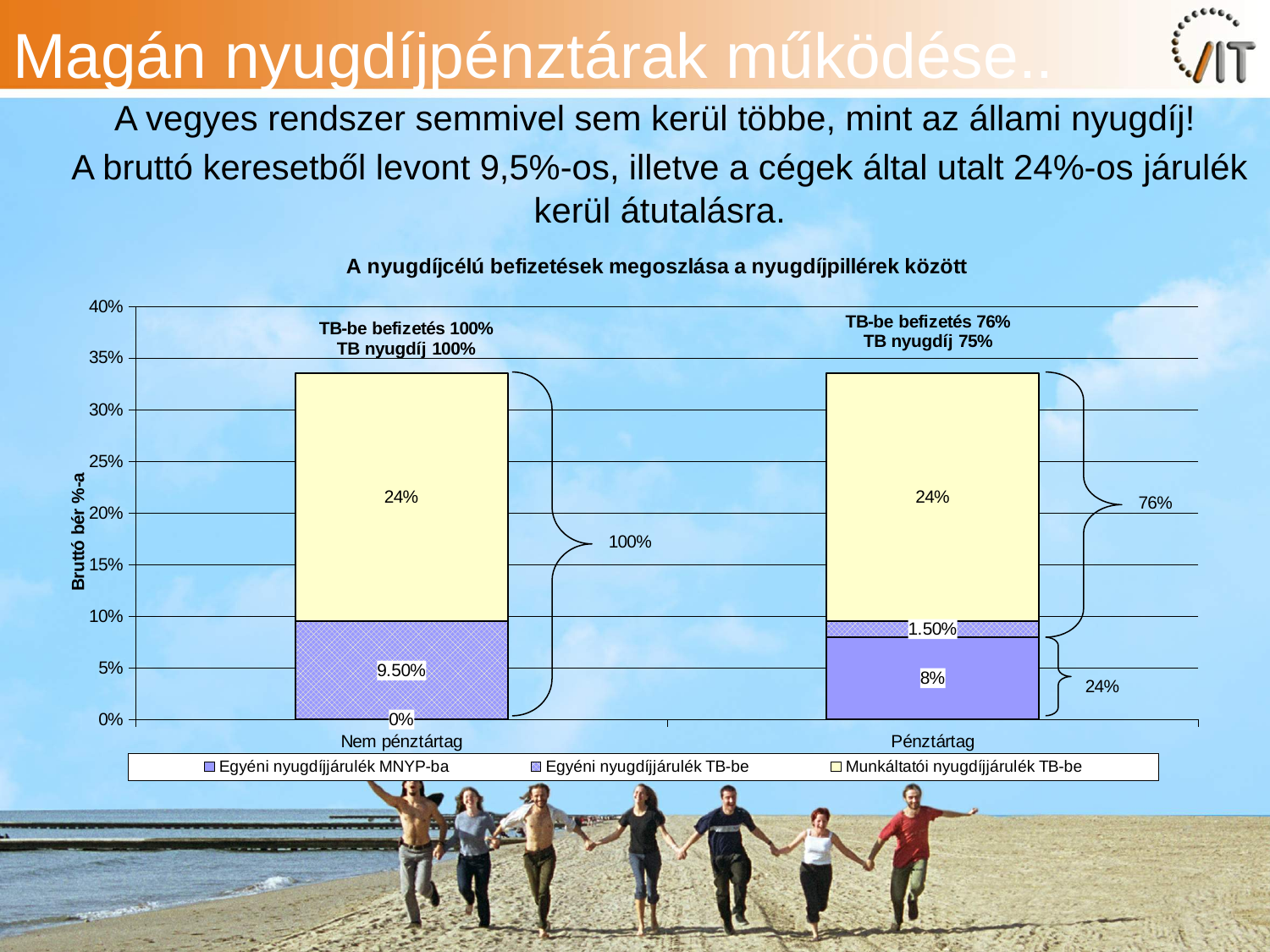
How many series does the legend list? 3 What kind of chart is shown on the slide? stacked bar chart How many categories are shown on the x axis? 2 What is the value of Egyéni nyugdíjjárulék MNYP-ba for Nem pénztártag? 0% What is the value of Egyéni nyugdíjjárulék TB-be for Nem pénztártag? 9.50% What is the value of Egyéni nyugdíjjárulék MNYP-ba for Pénztártag? 8% What is the difference between the Egyéni nyugdíjjárulék TB-be values for Nem pénztártag and Pénztártag? 8% What is the value of Munkáltatói nyugdíjjárulék TB-be for Nem pénztártag? 24% What is the title of the chart? A nyugdíjcélú befizetések megoszlása a nyugdíjpillérek között What is the total of the stacked bar for Pénztártag? 33.5% What is the value of Egyéni nyugdíjjárulék TB-be for Pénztártag? 1.50% Which is larger for Pénztártag: Egyéni nyugdíjjárulék MNYP-ba or Egyéni nyugdíjjárulék TB-be? Egyéni nyugdíjjárulék MNYP-ba